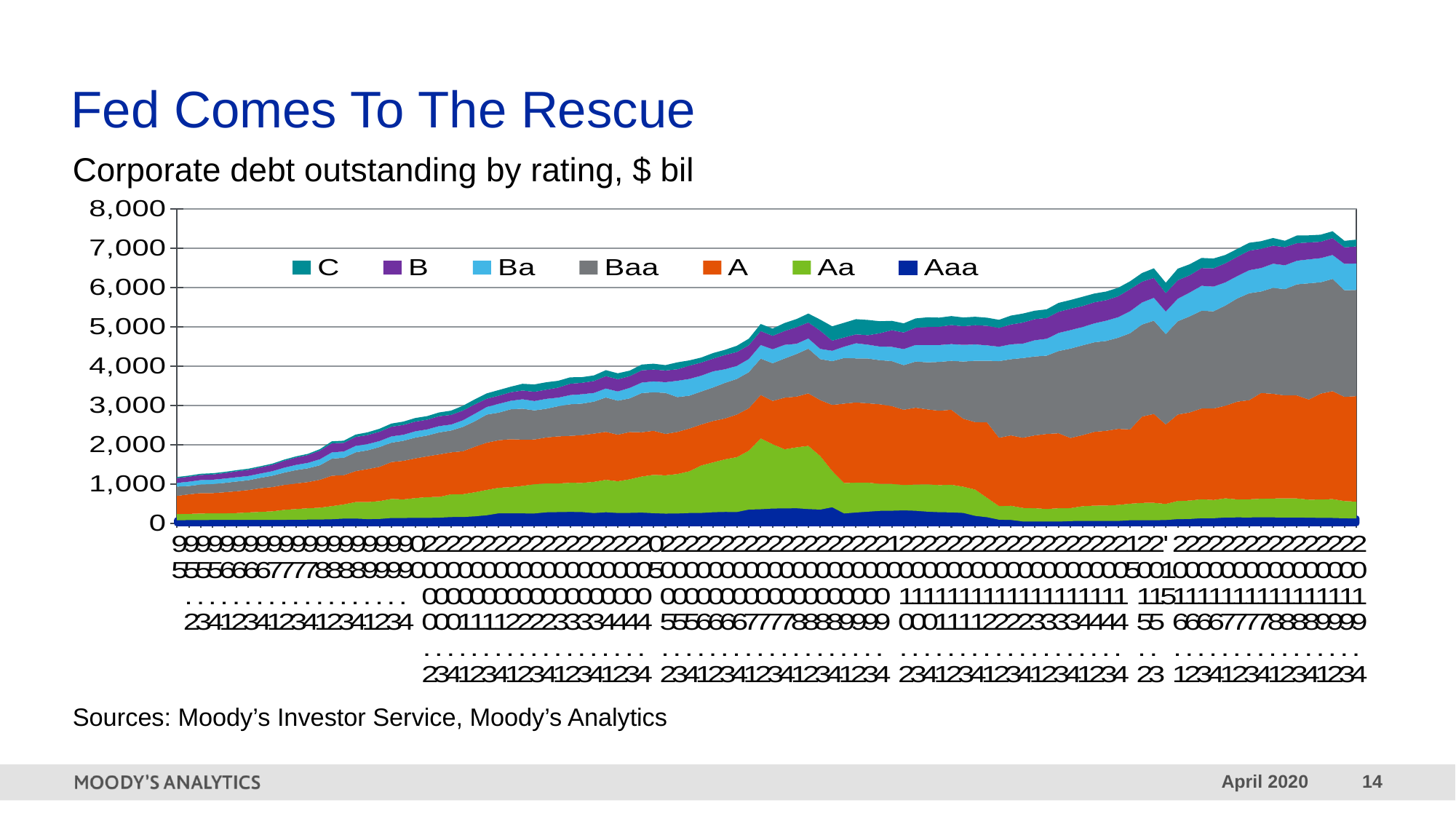
Is the total stacked value at the rightmost point of the chart greater or less than 8,000? less Which rating categories are listed in the legend, from left to right? C, B, Ba, Baa, A, Aa, Aaa How many series does the legend list? 7 What kind of chart is shown on the slide? Stacked area chart What is the highest value shown on the vertical axis? 8,000 Does the total corporate debt outstanding generally rise or fall from the left of the chart to the right? Rise Is the total stacked value at the leftmost point of the chart greater or less than 2,000? less What is the title of the chart (the subtitle below the slide heading)? Corporate debt outstanding by rating, $ bil Is the total stacked value at the rightmost point of the chart greater or less than 6,000? greater Which series forms the thinnest band at the right end of the chart? Aaa